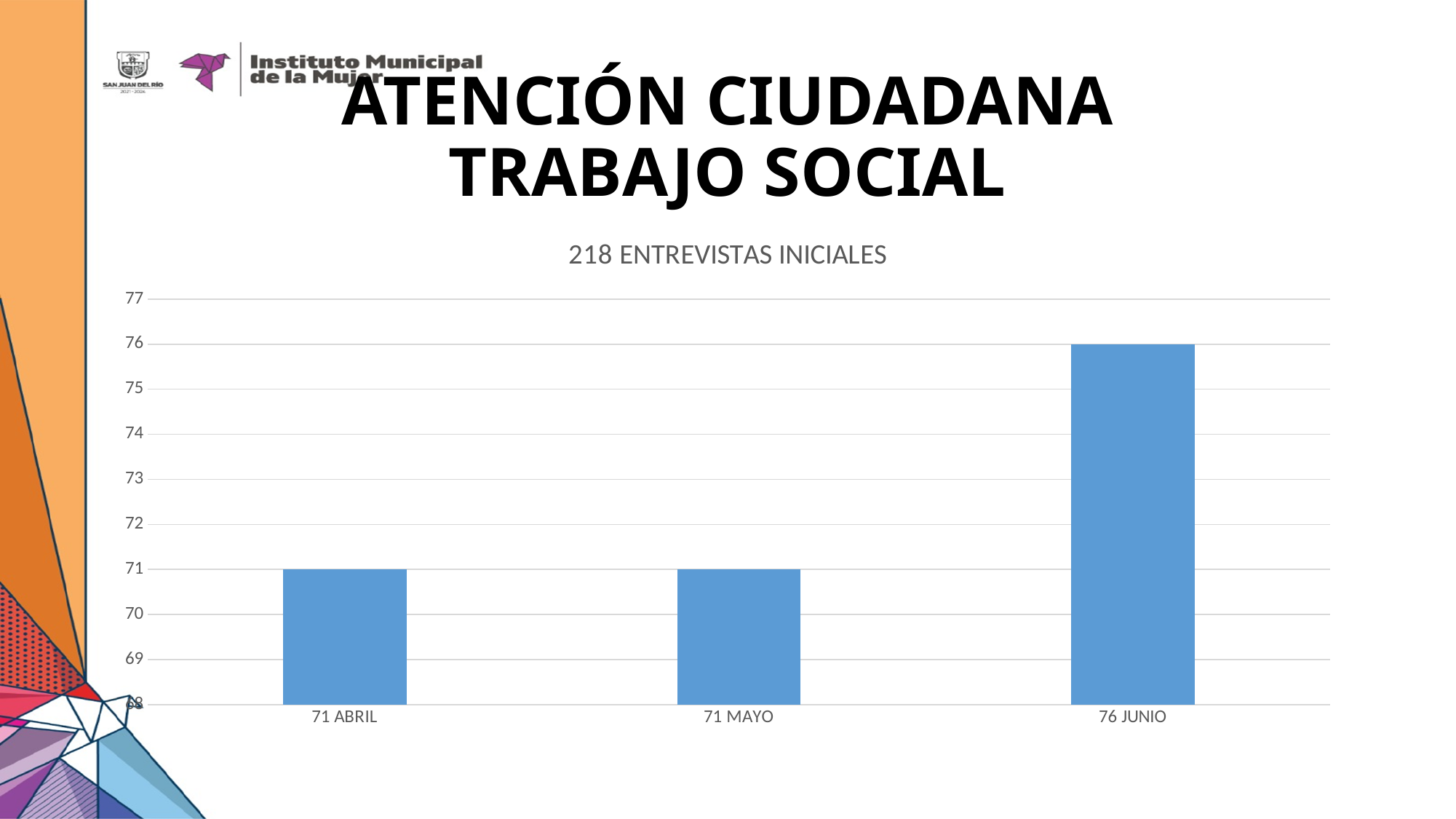
Is the value for JUNIO greater or less than 75? greater What is the total of the values for ABRIL, MAYO and JUNIO? 218 What is the value for MAYO? 71 Which is larger, the value for JUNIO or the value for MAYO? JUNIO Which month has the highest value? JUNIO What kind of chart is shown on the slide? bar chart What is the value for ABRIL? 71 What is the value for JUNIO? 76 How many months are shown on the chart? 3 What is the difference between the values for JUNIO and ABRIL? 5 What is the title of the chart? 218 ENTREVISTAS INICIALES Is the value for ABRIL greater or less than 72? less